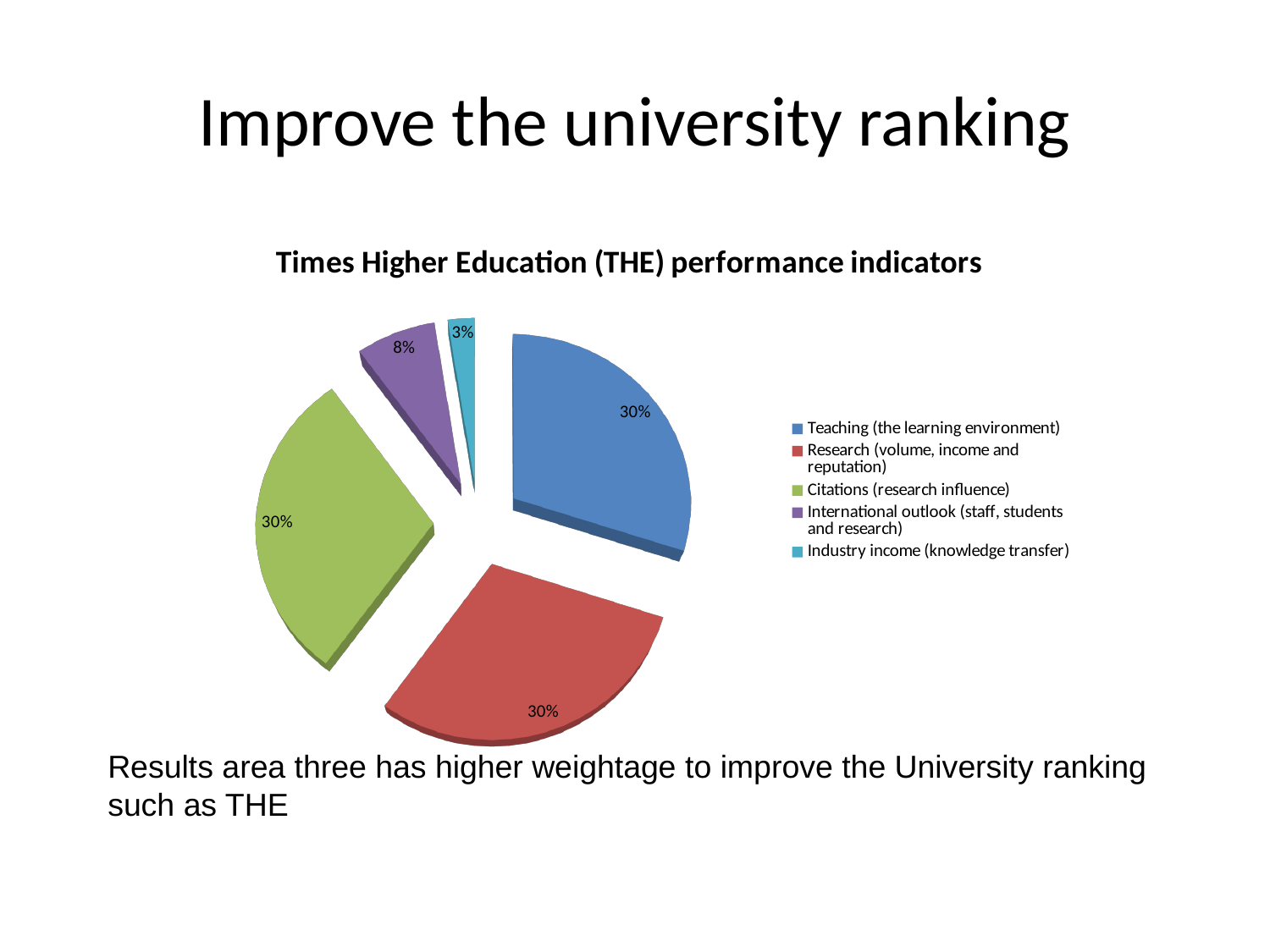
Which is larger, International outlook (staff, students and research) or Industry income (knowledge transfer)? International outlook (staff, students and research) How many slices does the pie chart have? 5 What colour is the slice for Research (volume, income and reputation)? red What is the difference in percentage points between International outlook (staff, students and research) and Industry income (knowledge transfer)? 5 How many entries does the legend list? 5 What share of the pie is Teaching (the learning environment)? 30% Which category has the smallest slice of the pie? Industry income (knowledge transfer) What share of the pie is International outlook (staff, students and research)? 8% What type of chart is shown on the slide? pie chart What share of the pie is Citations (research influence)? 30% What is the title of the chart? Times Higher Education (THE) performance indicators